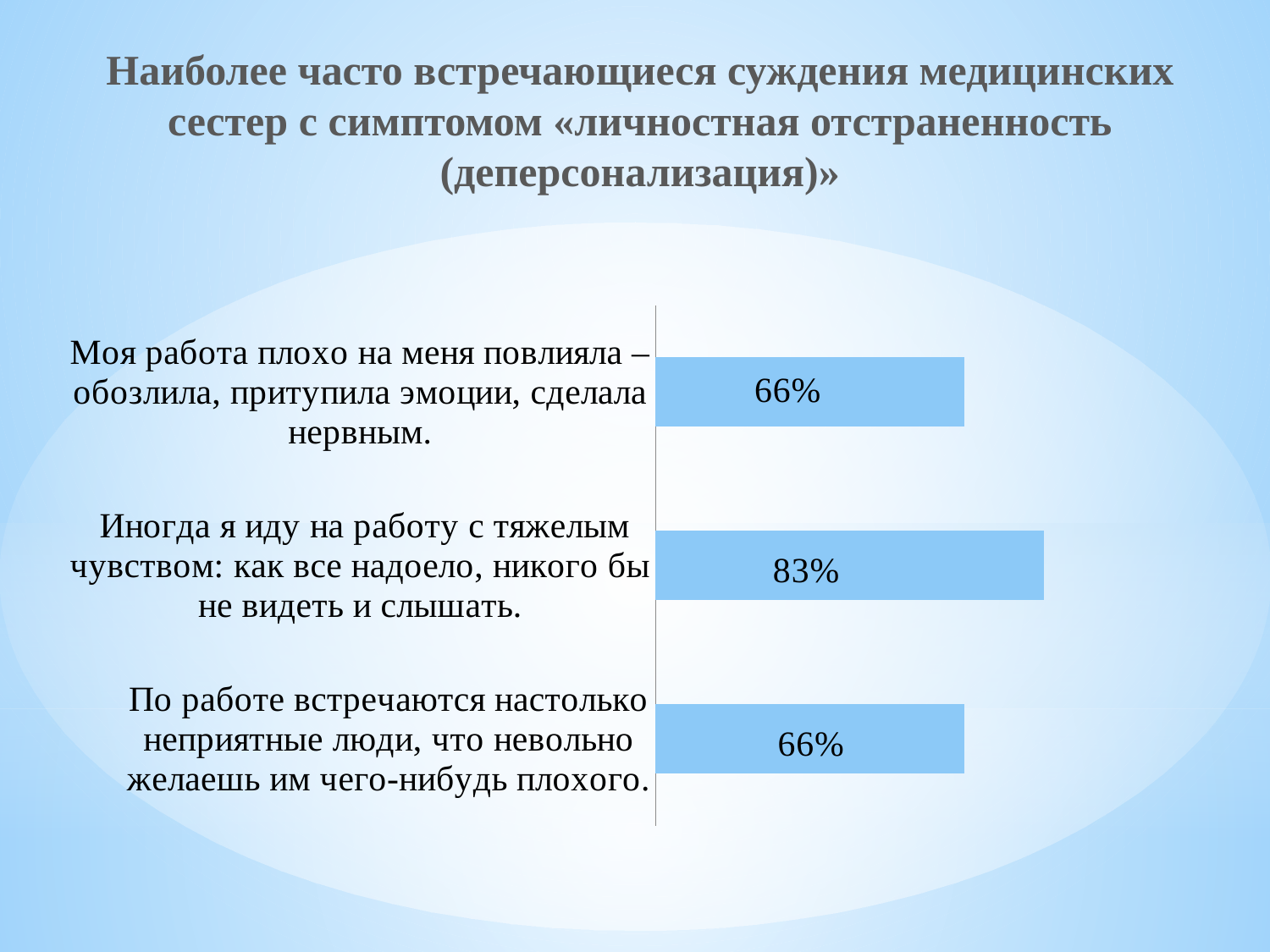
Which is larger: the value for "Иногда я иду на работу с тяжелым чувством..." or the value for "По работе встречаются настолько неприятные люди..."? Иногда я иду на работу с тяжелым чувством... What is the title of the slide? Наиболее часто встречающиеся суждения медицинских сестер с симптомом «личностная отстраненность (деперсонализация)» What value is shown for the statement "Иногда я иду на работу с тяжелым чувством: как все надоело, никого бы не видеть и слышать."? 83% Which statement has the highest value? Иногда я иду на работу с тяжелым чувством: как все надоело, никого бы не видеть и слышать. What is the difference between the value for "Иногда я иду на работу с тяжелым чувством..." and the value for "Моя работа плохо на меня повлияла..."? 17% How many statements (categories) are plotted in the chart? 3 What kind of chart is shown on the slide? Bar chart How many statements have a value of 66%? 2 What value is shown for the statement "По работе встречаются настолько неприятные люди, что невольно желаешь им чего-нибудь плохого."? 66% What colour are the bars in the chart? Light blue What value is shown for the statement "Моя работа плохо на меня повлияла – обозлила, притупила эмоции, сделала нервным."? 66%